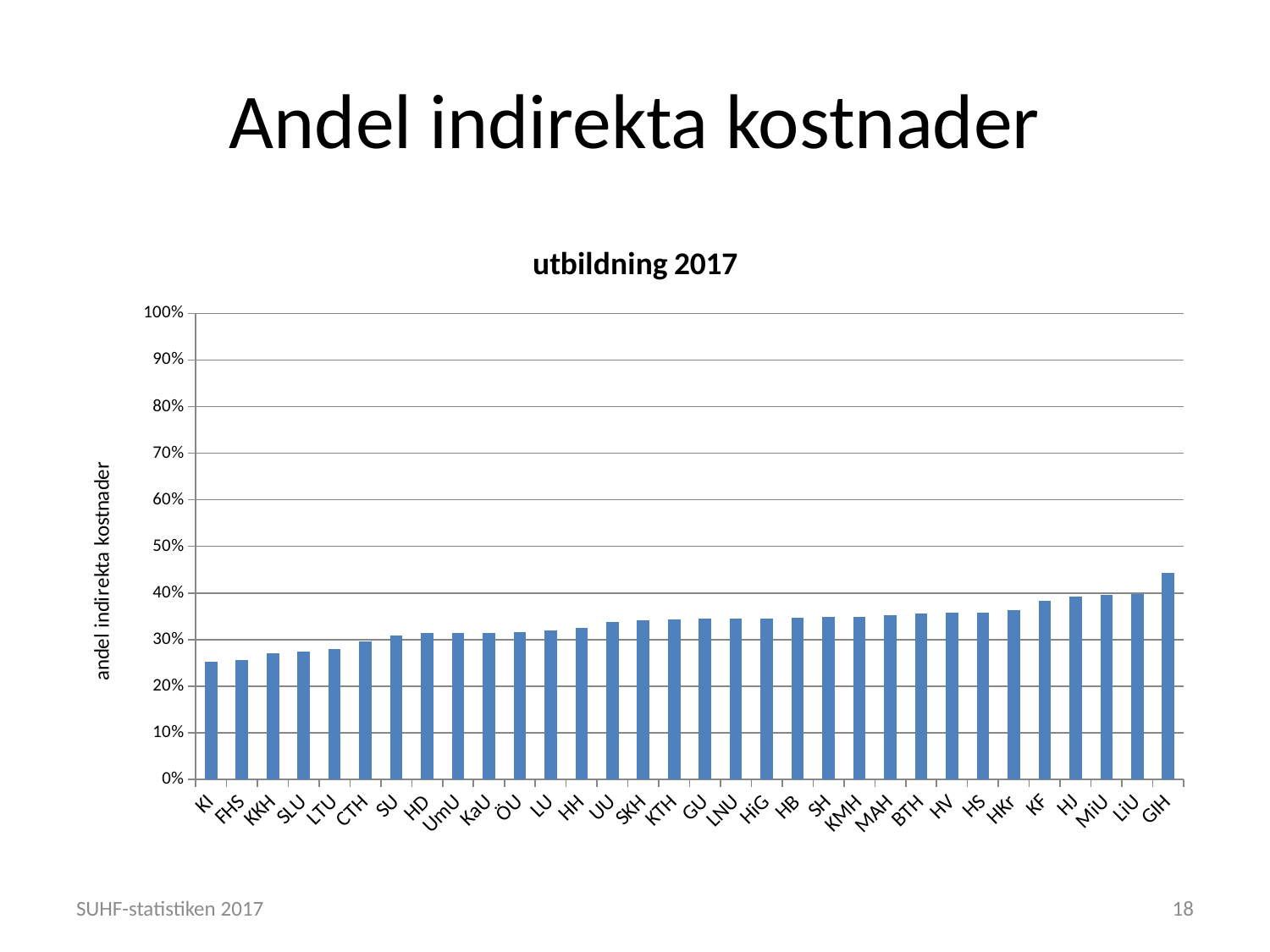
Which category has the lowest value in the chart? KI Which has the larger value, LiU or SLU? LiU Is the value for KI greater or less than 30%? less Which category has the highest value in the chart? GIH Is the value for UU greater or less than 30%? greater Do the values generally rise or fall from left to right along the x axis? rise What kind of chart is shown on the slide? bar chart What is the label on the vertical axis of the chart? andel indirekta kostnader How many categories (bars) are shown in the chart? 32 What is the title of the chart? utbildning 2017 Is the value for GIH greater or less than 40%? greater